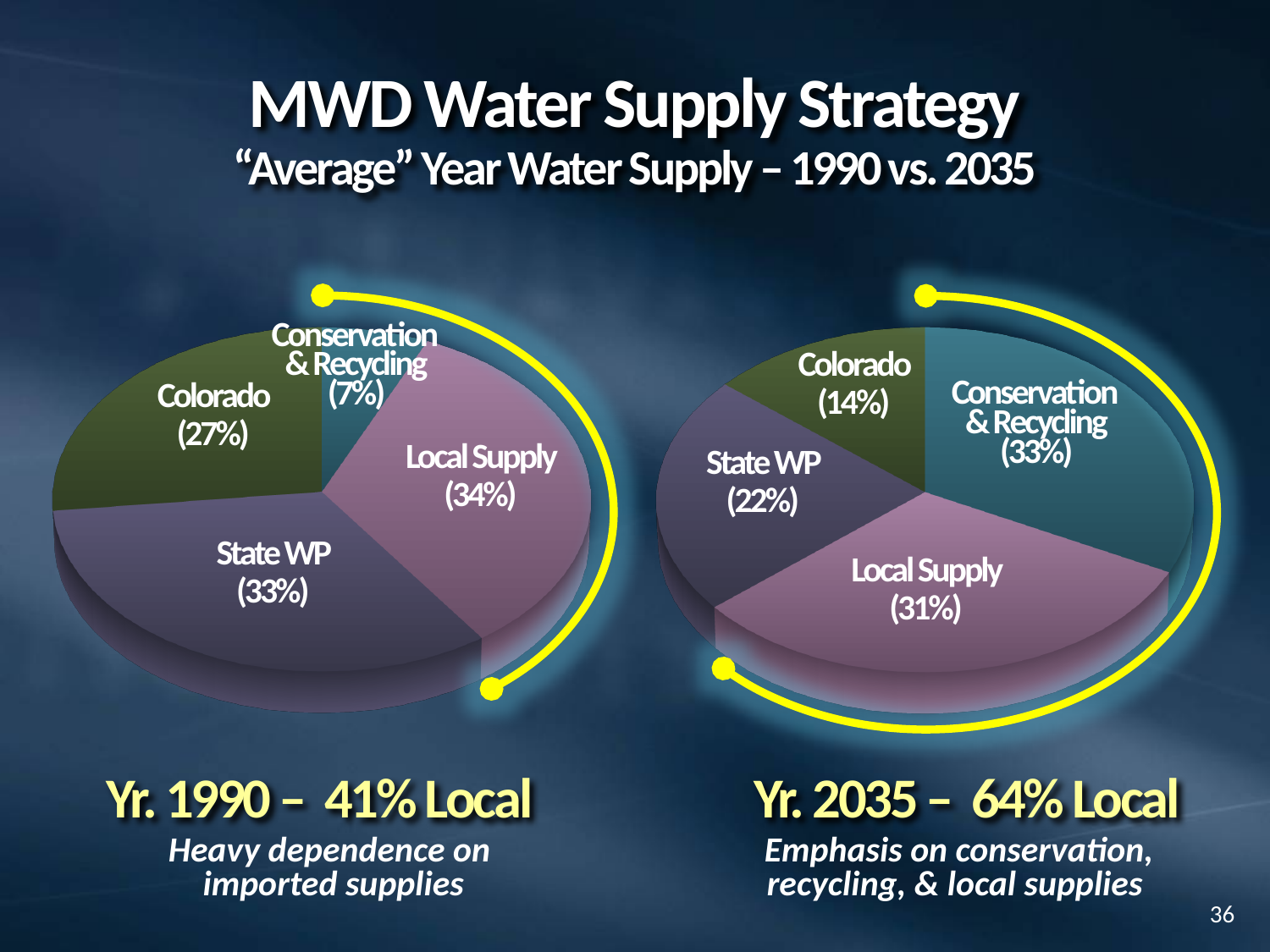
In the 2035 pie chart (right), what share is Colorado? 14% In the 1990 pie chart (left), which is larger, Colorado or State WP? State WP In the 1990 pie chart (left), what is the difference between the Colorado share and the Conservation & Recycling share? 20% In the 2035 pie chart (right), what is the difference between the Conservation & Recycling share and the Colorado share? 19% What is the main title of the slide containing the two pie charts? MWD Water Supply Strategy In the 2035 pie chart (right), which category has the smallest share? Colorado In the 1990 pie chart (left), what share is Local Supply? 34% What type of chart is used on this slide? Pie chart How many slices does the 2035 pie chart (right) have? 4 In the 2035 pie chart (right), what share is State WP? 22% In the 1990 pie chart (left), what share is Conservation & Recycling? 7% In the 1990 pie chart (left), which category has the smallest share? Conservation & Recycling